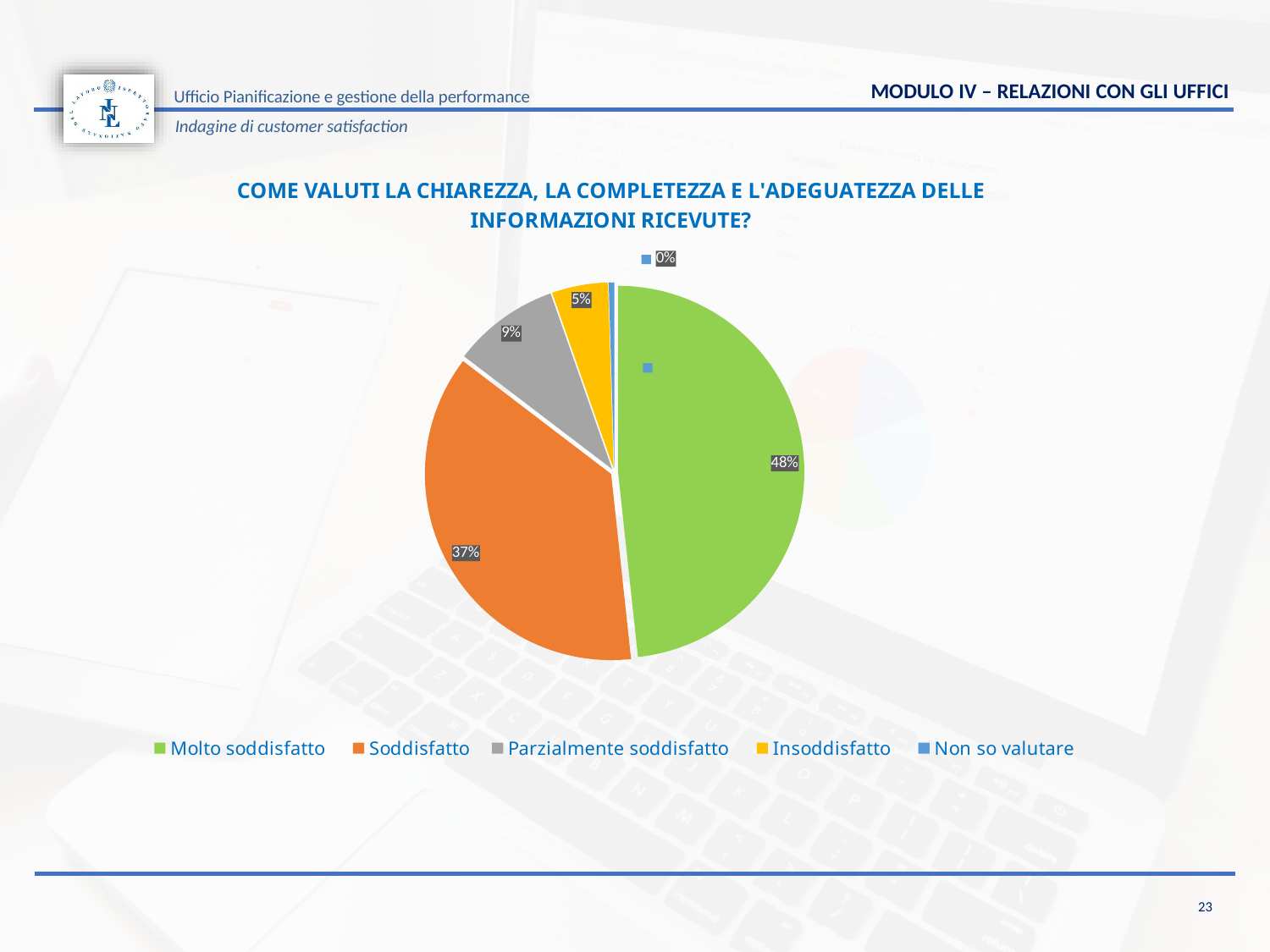
What share of the pie does "Insoddisfatto" represent? 5% Which category has the smallest slice of the pie? Non so valutare What share of the pie does "Non so valutare" represent? 0% Which is larger, the share for "Parzialmente soddisfatto" or the share for "Insoddisfatto"? Parzialmente soddisfatto Which category has the largest slice of the pie? Molto soddisfatto What kind of chart is shown on the slide? Pie chart What share of the pie does "Parzialmente soddisfatto" represent? 9% What colour is the slice for "Soddisfatto"? Orange What is the difference in percentage points between "Molto soddisfatto" and "Soddisfatto"? 11 How many categories does the legend list? 5 What share of the pie does "Molto soddisfatto" represent? 48% What share of the pie does "Soddisfatto" represent? 37%